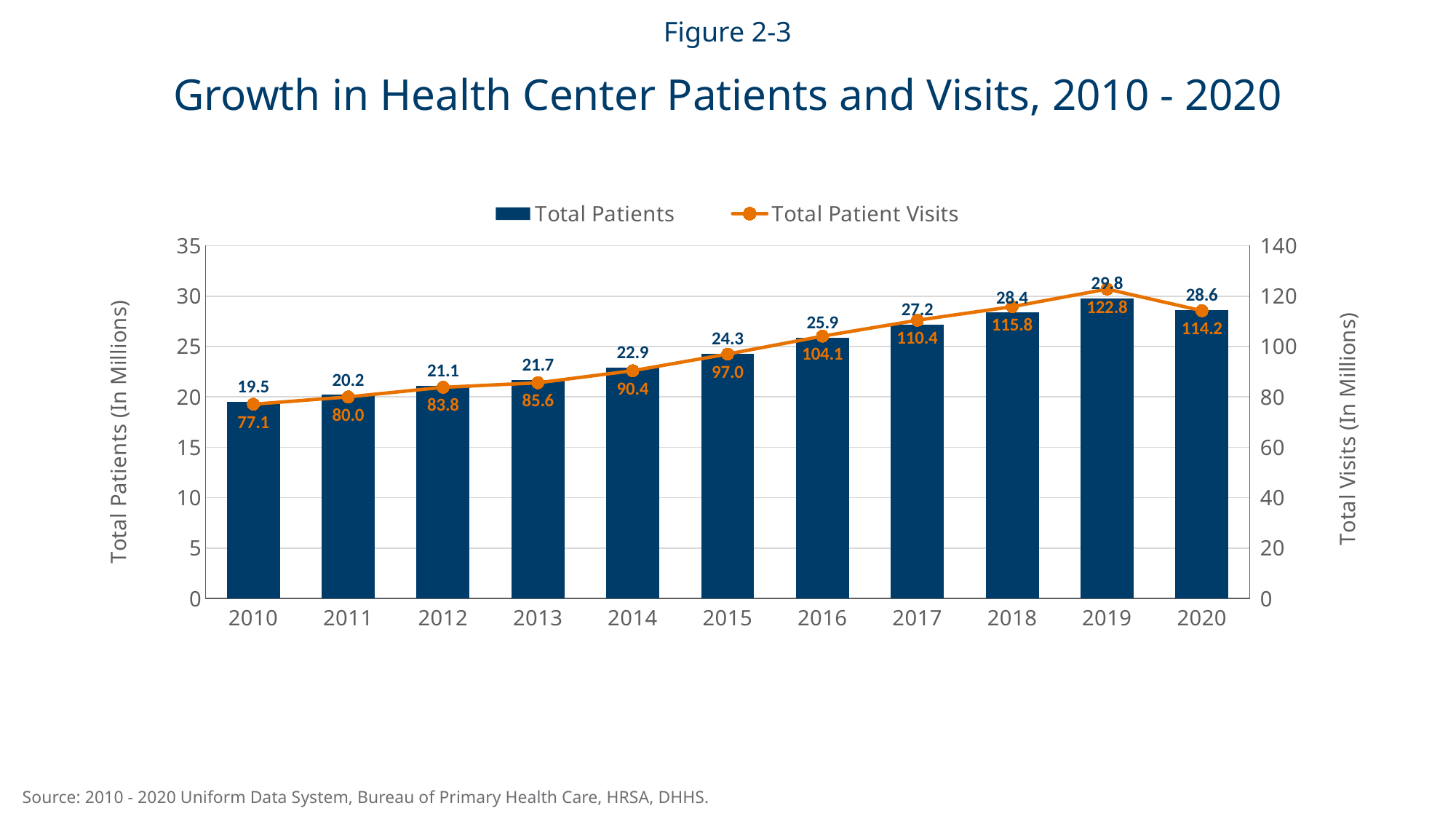
Is the value for Total Patient Visits in 2019 greater or less than 120? greater What is the value for Total Patients in 2015? 24.3 What is the difference between Total Patient Visits in 2019 and in 2020? 8.6 What is the value for Total Patient Visits in 2018? 115.8 Which is larger, Total Patients in 2016 or in 2017? 2017 Do the Total Patients values rise or fall from 2010 to 2019? rise What is the difference between Total Patients in 2020 and in 2010? 9.1 Which year has the lowest value for Total Patient Visits? 2010 What kind of chart is this? Combined bar and line chart Which year has the highest value for Total Patients? 2019 How many series does the legend list? 2 How many years are shown on the x axis? 11